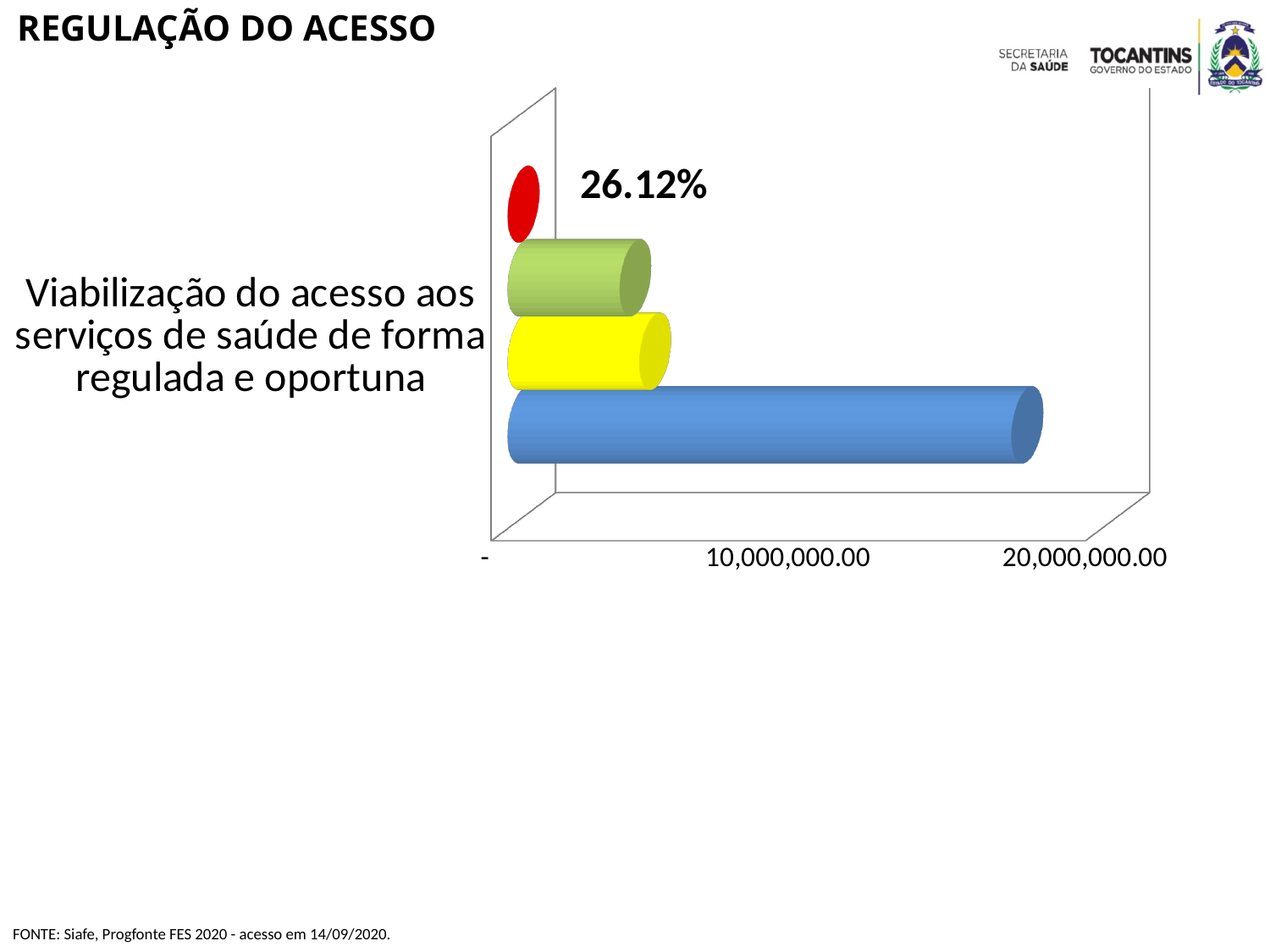
Is the value of the blue bar greater or less than 10,000,000.00? greater What kind of chart is shown on the slide? Bar chart How many bars are plotted for the single category in the chart? 4 What is the category label shown on the chart? Viabilização do acesso aos serviços de saúde de forma regulada e oportuna What is the highest tick value shown on the horizontal axis? 20,000,000.00 How many categories are shown on the vertical axis of the chart? 1 Which coloured bar is the longest in the chart? The blue bar Is the value of the yellow bar greater or less than 10,000,000.00? less Which is larger, the blue bar or the yellow bar? The blue bar Is the value of the green bar greater or less than 10,000,000.00? less What percentage is printed as a data label on the chart? 26.12% Which coloured bar is the shortest in the chart? The red bar